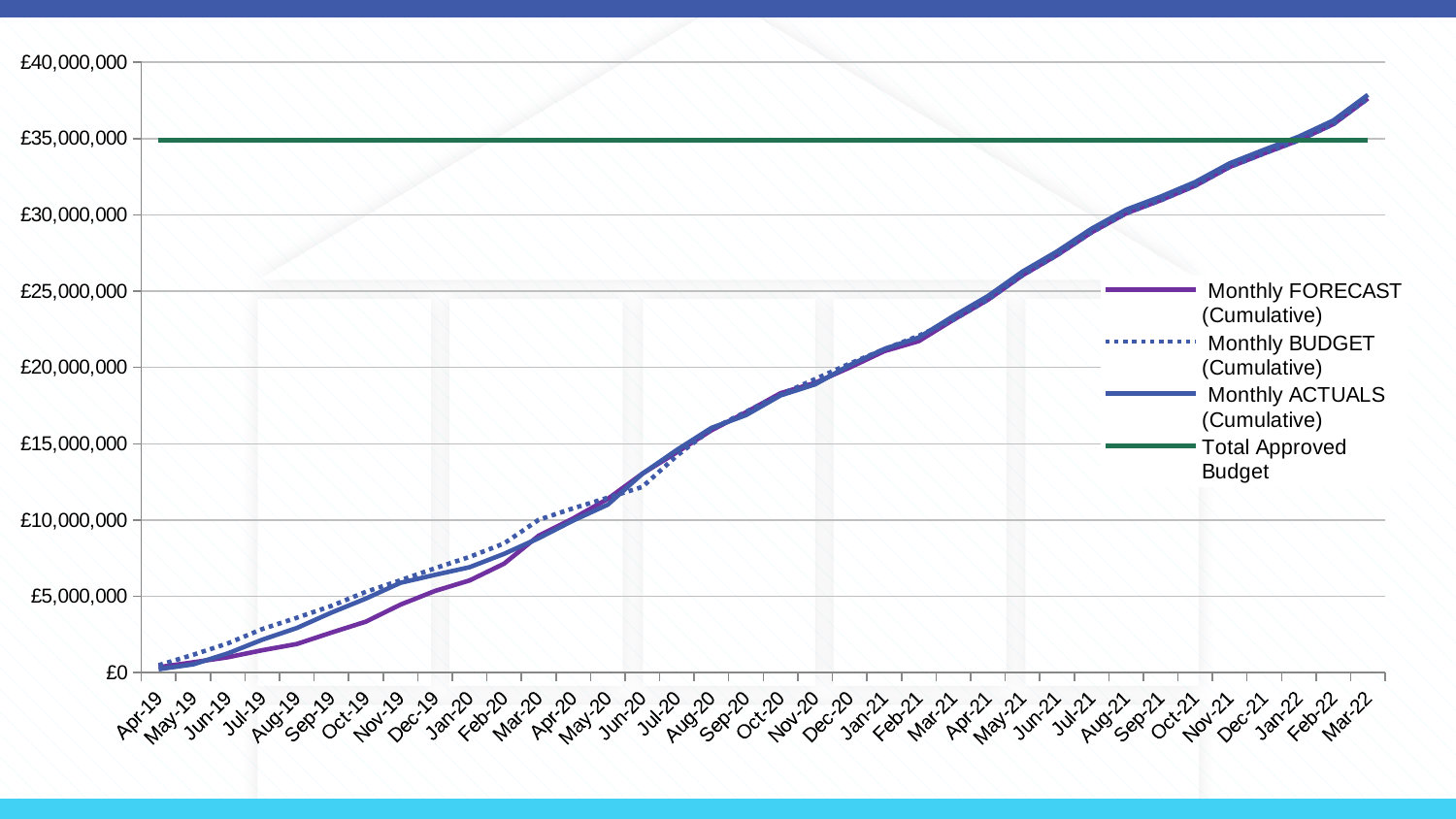
Is the value of Monthly FORECAST (Cumulative) at Jan-20 greater or less than £5,000,000? greater Which series is drawn as a flat horizontal line across the chart? Total Approved Budget Is the value of Monthly ACTUALS (Cumulative) at Sep-20 greater or less than £15,000,000? greater Is the value of Monthly ACTUALS (Cumulative) at Mar-22 greater or less than £35,000,000? greater Does the Monthly ACTUALS (Cumulative) line rise or fall from Apr-19 to Mar-22? Rise What kind of chart is shown on the slide? Line chart Which series is drawn as a dotted line? Monthly BUDGET (Cumulative) How many months are shown along the x axis? 36 How many series does the legend list? 4 At Aug-19, which is higher: Monthly BUDGET (Cumulative) or Monthly FORECAST (Cumulative)? Monthly BUDGET (Cumulative) At Mar-22, which is higher: Monthly ACTUALS (Cumulative) or Total Approved Budget? Monthly ACTUALS (Cumulative)